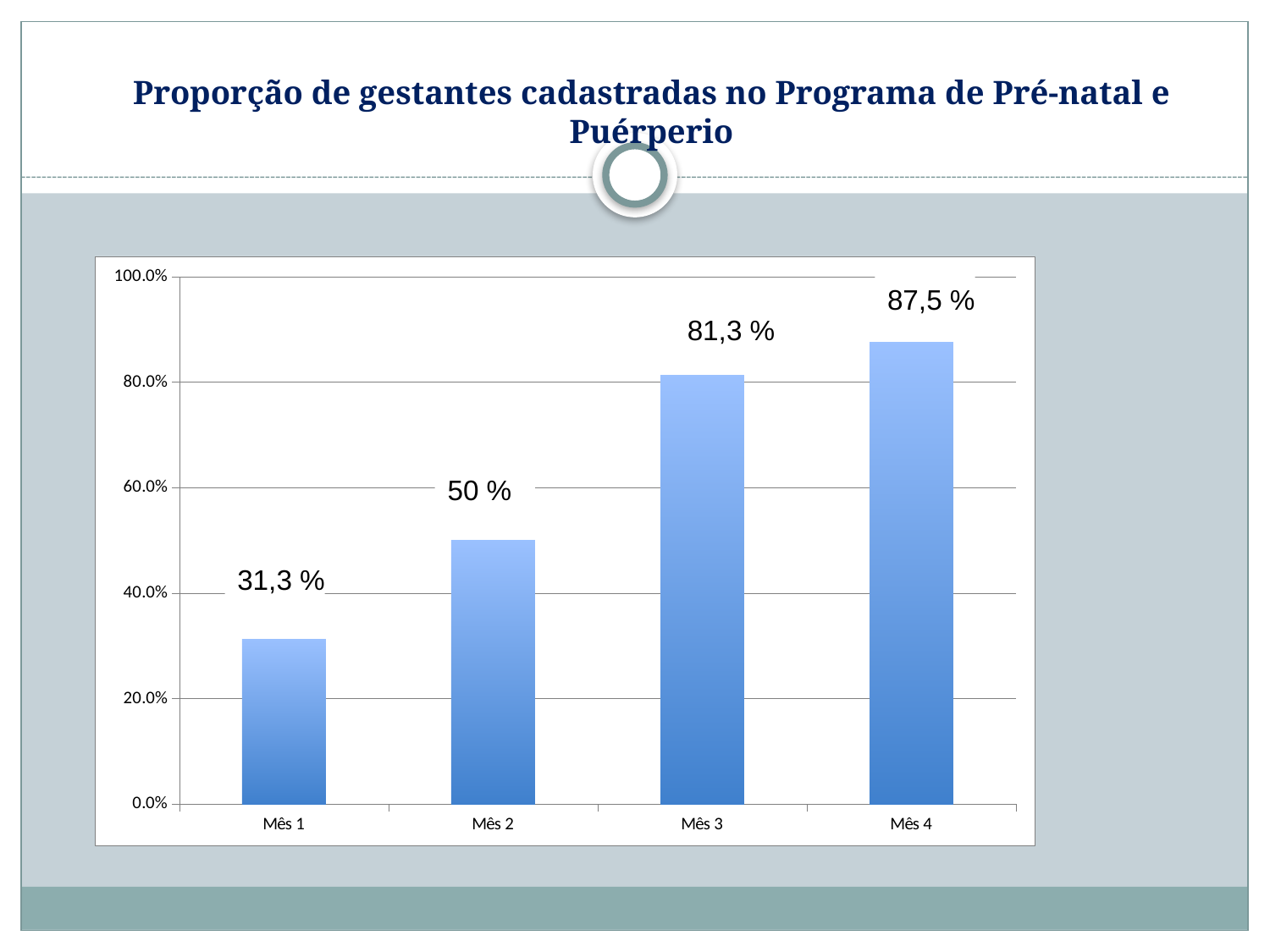
What kind of chart is shown on the slide? bar chart What is the value for Mês 1? 31,3 % Which month has the highest value? Mês 4 Which month has the lowest value? Mês 1 Do the values rise or fall from Mês 1 to Mês 4? rise Which is larger, the value for Mês 2 or the value for Mês 3? Mês 3 What is the value for Mês 3? 81,3 % How many months are shown on the x axis? 4 What is the difference between the values for Mês 3 and Mês 2? 31,3 % Is the value for Mês 2 greater or less than 40.0%? greater What is the difference between the values for Mês 4 and Mês 1? 56,2 % What is the value for Mês 4? 87,5 %